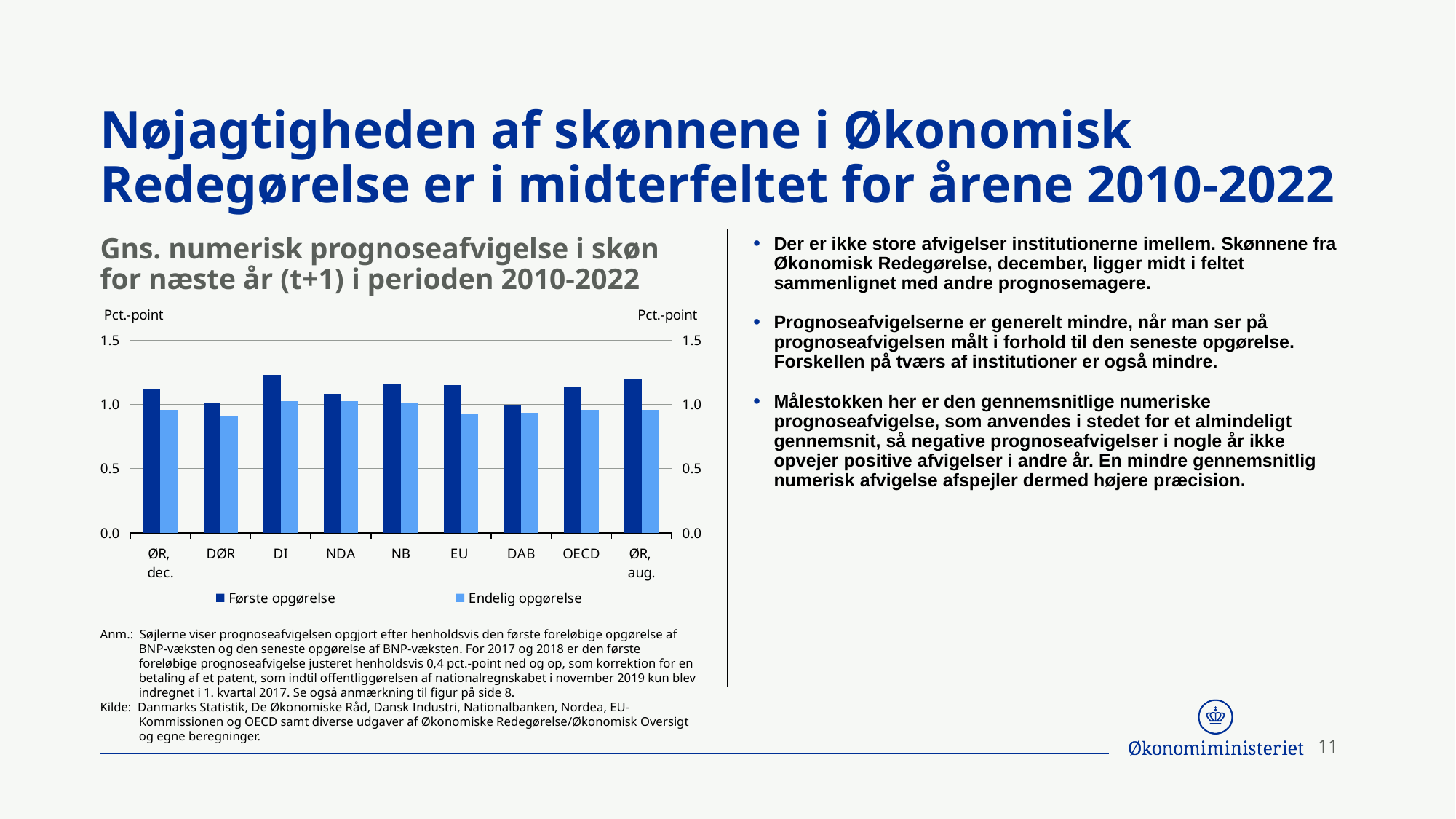
How many institutions (categories) are shown on the x axis of the chart? 9 What unit is shown on the chart's y axis? Pct.-point Is the Første opgørelse value for ØR, dec. greater or less than 1.0? greater Is the Første opgørelse value for DI greater or less than 1.0? greater Is the Første opgørelse value for ØR, aug. greater or less than 1.5? less For DI, which is larger: the Første opgørelse value or the Endelig opgørelse value? Første opgørelse For EU, which is larger: the Første opgørelse value or the Endelig opgørelse value? Første opgørelse What kind of chart is shown on the slide? bar chart What are the two series named in the chart's legend? Første opgørelse and Endelig opgørelse How many series does the chart's legend list? 2